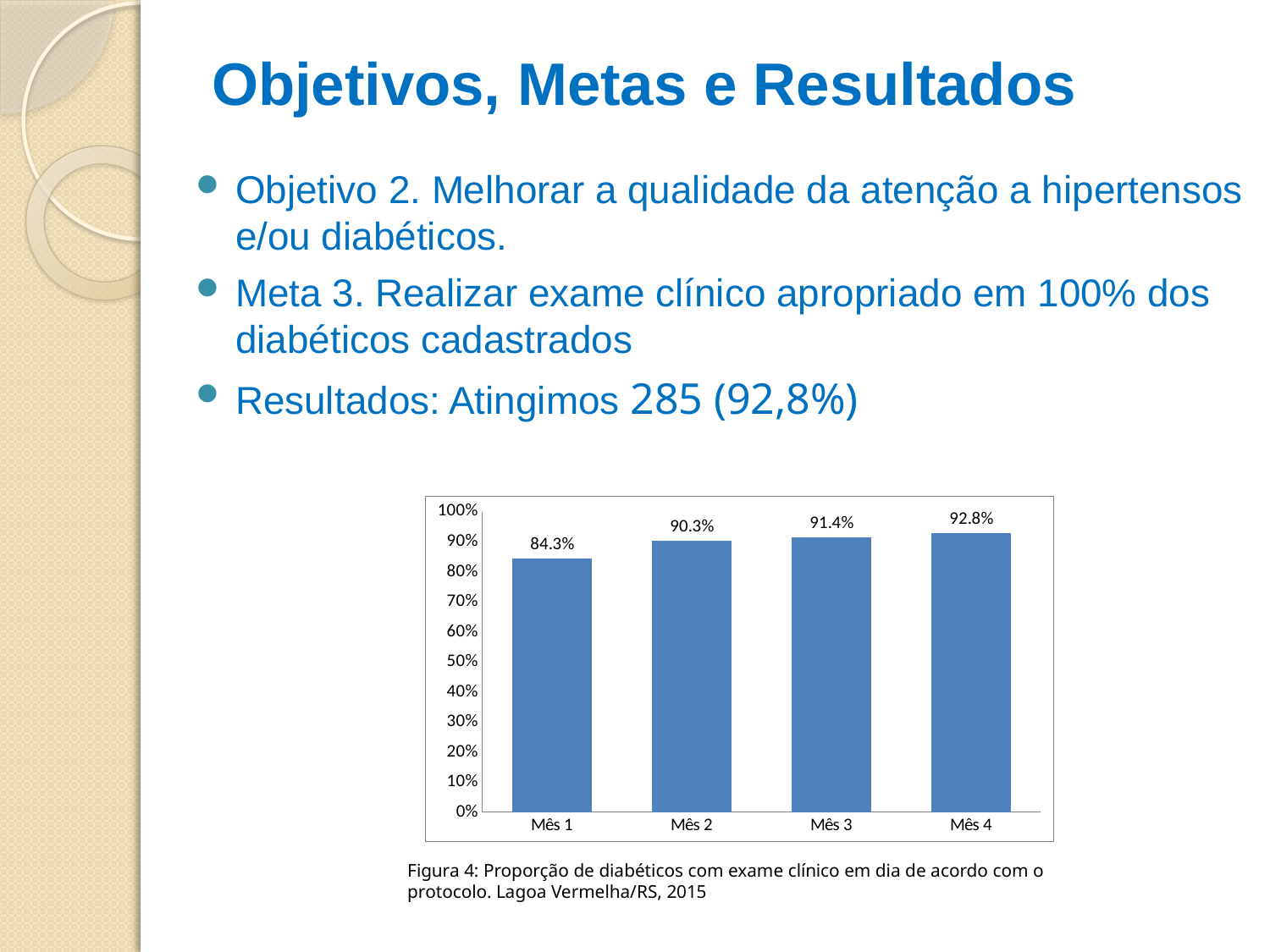
What is the value for Mês 4? 92.8% What is the value for Mês 3? 91.4% Is the value for Mês 1 greater or less than 80%? greater Which is larger, the value for Mês 2 or the value for Mês 1? Mês 2 Do the values rise or fall from Mês 1 to Mês 4? rise What is the value for Mês 2? 90.3% How many months are shown on the x axis? 4 Which month has the lowest value? Mês 1 What is the value for Mês 1? 84.3% Which month has the highest value? Mês 4 What kind of chart is shown on the slide? bar chart What is the difference between the values for Mês 4 and Mês 1? 8.5%